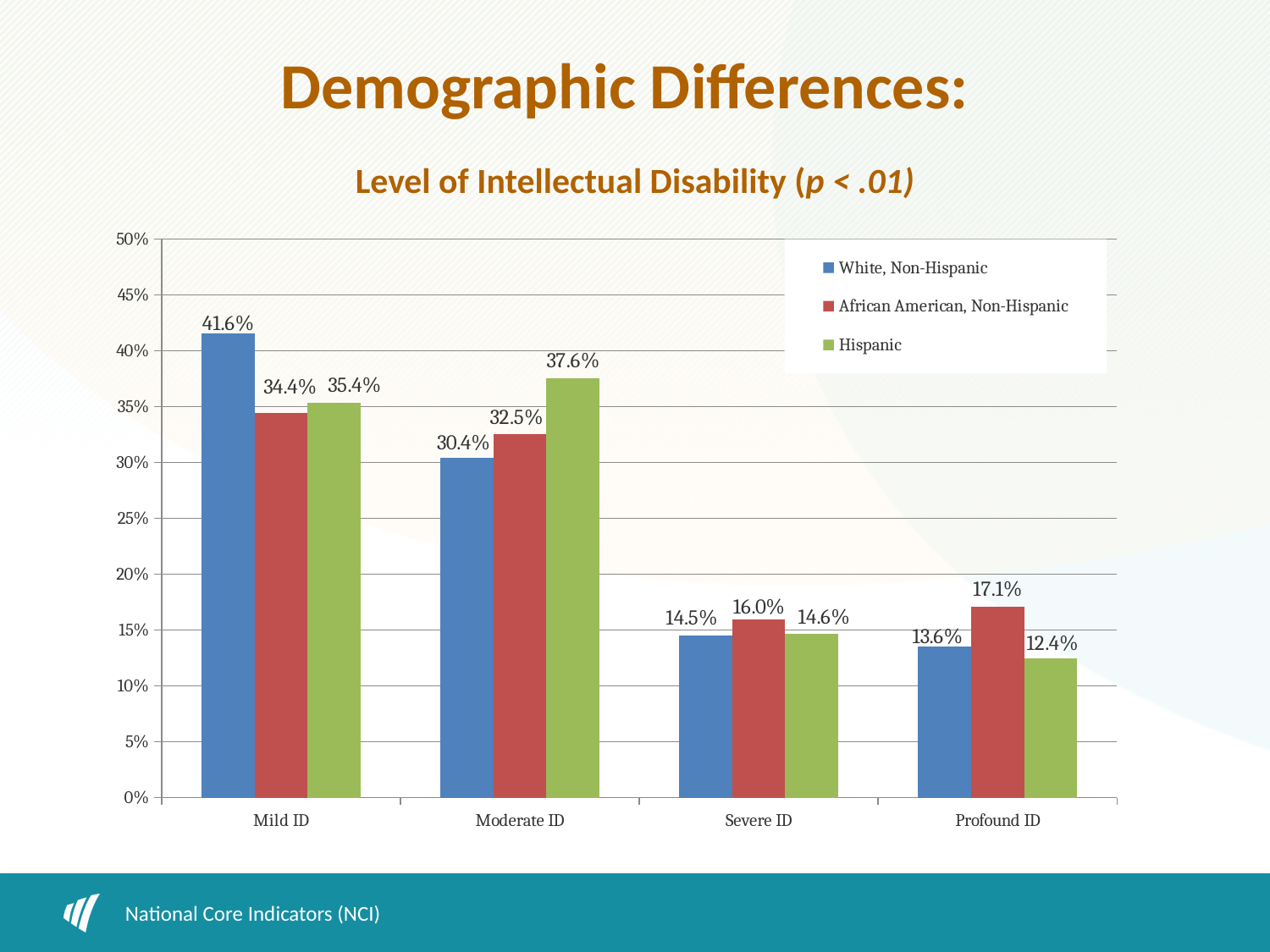
Which category has the lowest value for the Hispanic series? Profound ID Which colour represents the Hispanic series in the chart? Green How many categories are shown on the x axis? 4 What is the value for Hispanic in the Moderate ID category? 37.6% How many series does the legend list? 3 What is the difference between the Hispanic and White, Non-Hispanic values in the Moderate ID category? 7.2% What is the value for African American, Non-Hispanic in the Profound ID category? 17.1% What is the value for White, Non-Hispanic in the Mild ID category? 41.6% Which category has the highest value for the White, Non-Hispanic series? Mild ID In the Severe ID category, which is larger: the African American, Non-Hispanic value or the White, Non-Hispanic value? African American, Non-Hispanic What kind of chart is shown on the slide? Bar chart Is the value for White, Non-Hispanic in the Mild ID category greater or less than 40%? greater